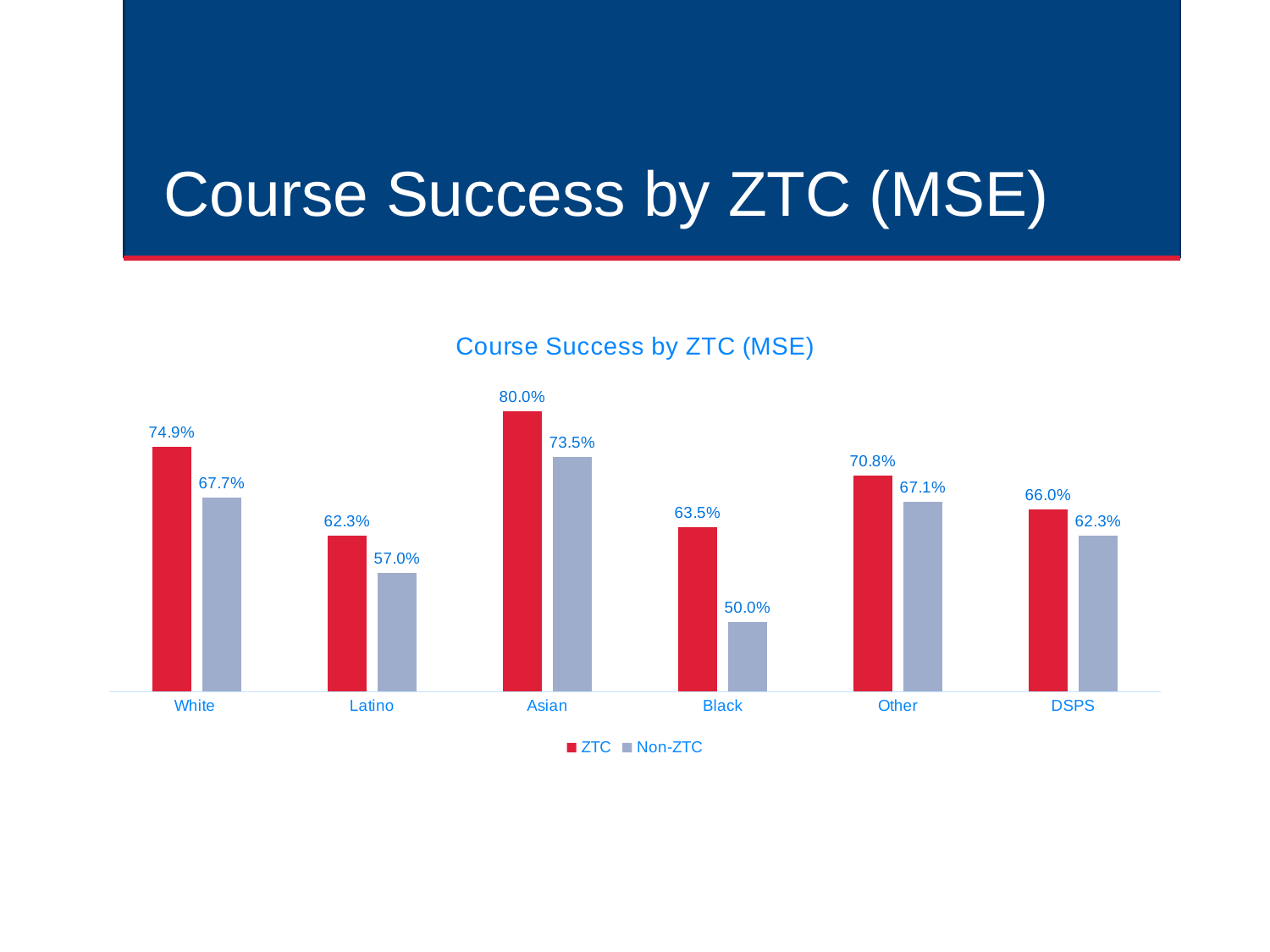
How many categories are shown on the x axis? 6 What is the difference between the ZTC and Non-ZTC values for White students? 7.2% What kind of chart is shown on the slide? Bar chart Which category has the highest ZTC course success rate? Asian How many series does the legend list? 2 What is the ZTC course success rate for Asian students? 80.0% What is the Non-ZTC course success rate for Black students? 50.0% What is the ZTC value for DSPS? 66.0% Which is larger, the ZTC value for Latino or the Non-ZTC value for White? Non-ZTC value for White What is the difference between the ZTC and Non-ZTC values for Black students? 13.5% Which category has the lowest Non-ZTC course success rate? Black What colour are the ZTC bars? Red